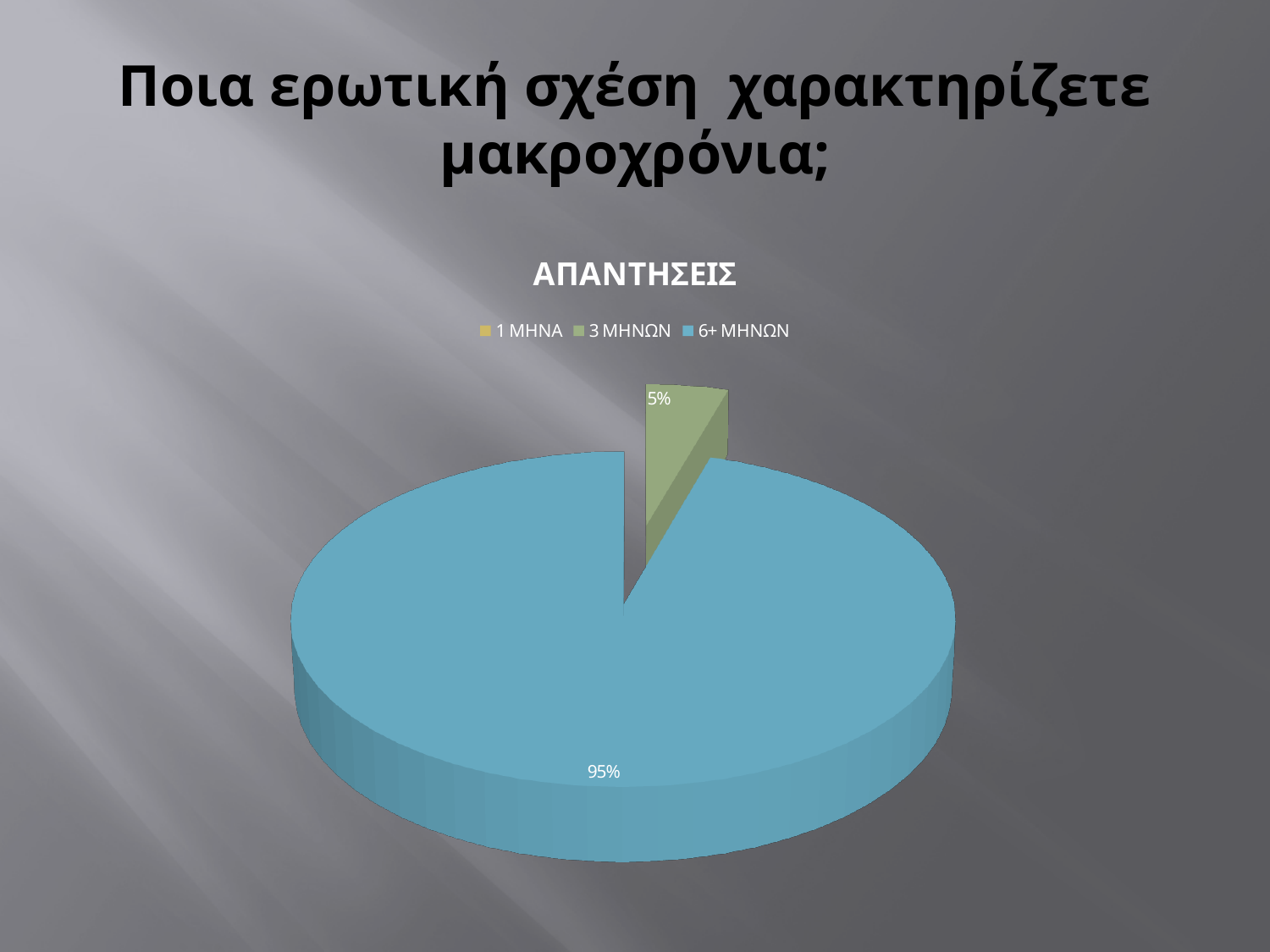
What kind of chart is shown on the slide? pie chart What percentage of the pie does the 3 ΜΗΝΩΝ slice represent? 5% What is the difference in percentage points between the 6+ ΜΗΝΩΝ slice and the 3 ΜΗΝΩΝ slice? 90 How many entries does the chart legend list? 3 What is the title of the chart? ΑΠΑΝΤΗΣΕΙΣ Which is larger, the 3 ΜΗΝΩΝ slice or the 6+ ΜΗΝΩΝ slice? 6+ ΜΗΝΩΝ Which category has the largest slice of the pie? 6+ ΜΗΝΩΝ How many slices have a percentage label printed on the pie? 2 What colour is the 6+ ΜΗΝΩΝ slice? blue What percentage of the pie does the 6+ ΜΗΝΩΝ slice represent? 95% Is the share for 6+ ΜΗΝΩΝ greater or less than 50%? greater